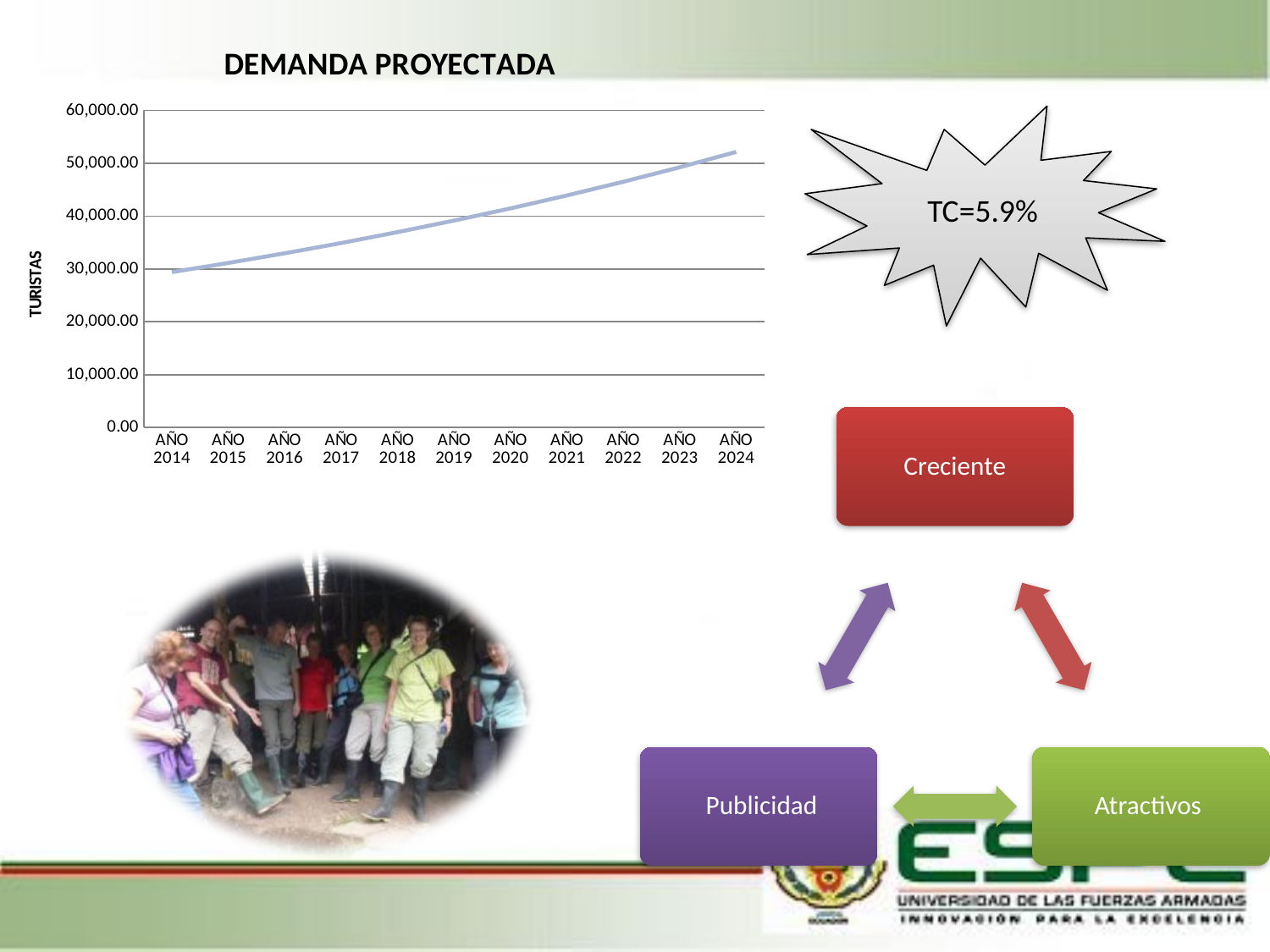
Which is larger, the value for AÑO 2016 or the value for AÑO 2021? AÑO 2021 Is the value for AÑO 2024 greater or less than 50,000.00? greater What is the title of the chart? DEMANDA PROYECTADA Which year has the highest value on the chart? AÑO 2024 Is the value for AÑO 2022 greater or less than 40,000.00? greater Do the values rise or fall from AÑO 2014 to AÑO 2024? rise Which year has the lowest value on the chart? AÑO 2014 How many years are shown along the x axis of the chart? 11 What is the label on the vertical axis of the chart? TURISTAS What kind of chart is shown on the slide? line chart